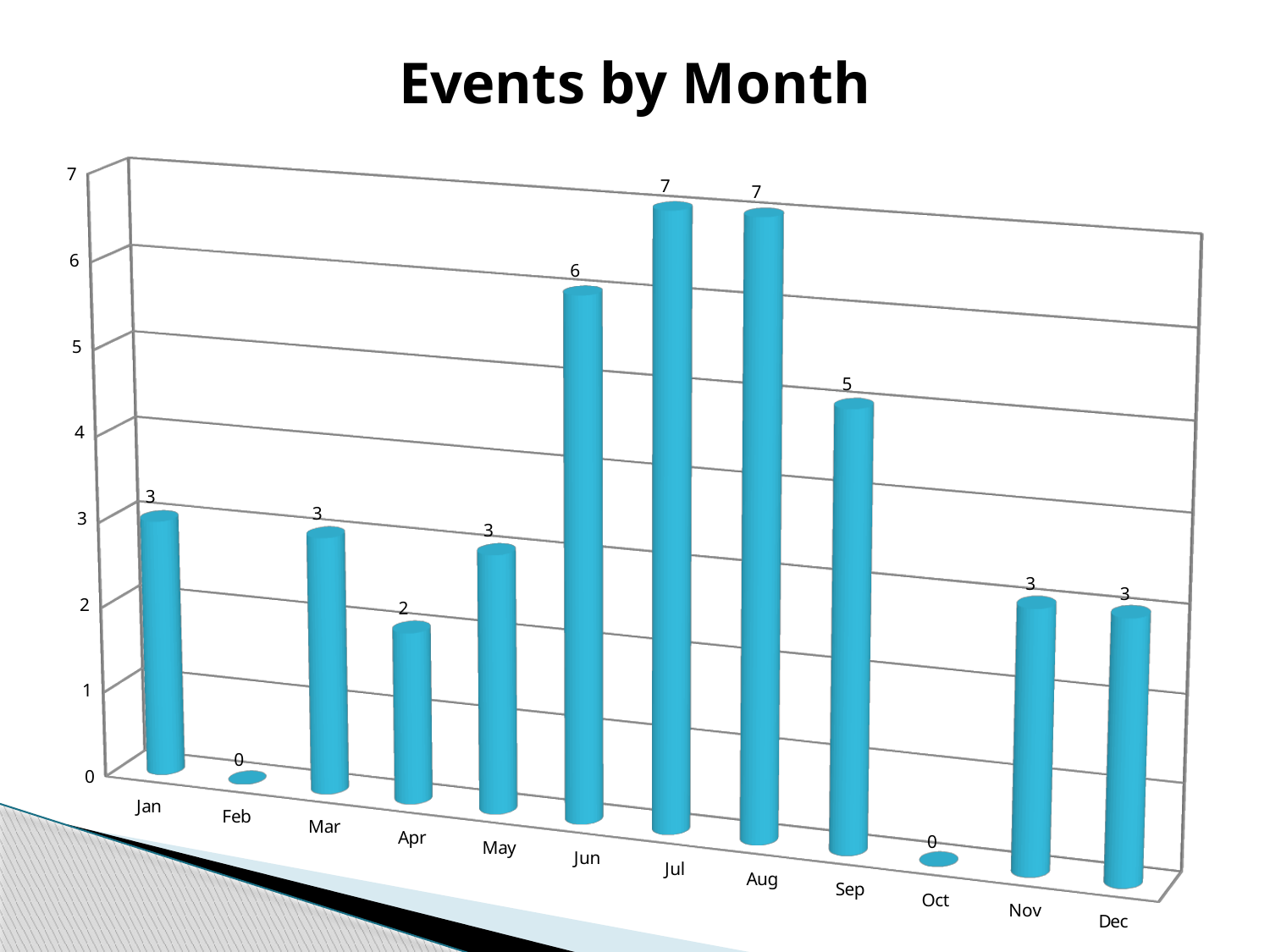
What is the difference between the values for Jun and Apr? 4 What is the value for Apr? 2 Which has a larger value, Apr or May? May What kind of chart is shown on the slide? Bar chart What is the value for Jun in the Events by Month chart? 6 How many months are shown on the x axis? 12 What is the value shown for Oct? 0 How many events are shown for Sep? 5 What is the highest value plotted in the chart? 7 What is the title of the chart? Events by Month Which has a larger value, Aug or Nov? Aug What is the difference between the values for Jul and Sep? 2